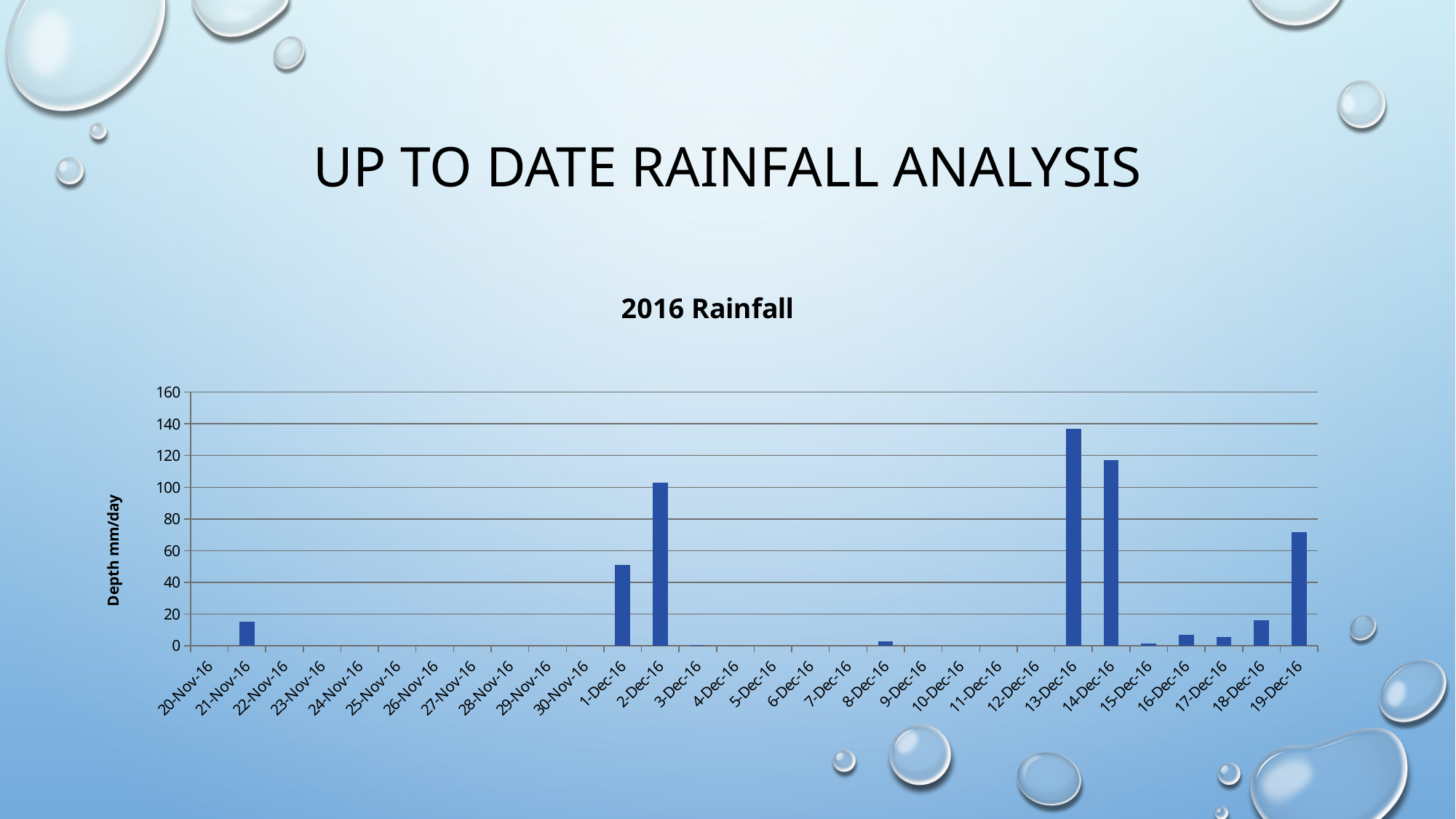
Is the value for 2-Dec-16 greater or less than 100? greater Is the value for 19-Dec-16 greater or less than 80? less Which date has the highest rainfall depth? 13-Dec-16 Which is larger, the value for 2-Dec-16 or the value for 19-Dec-16? 2-Dec-16 Which is larger, the value for 13-Dec-16 or the value for 14-Dec-16? 13-Dec-16 Is the value for 1-Dec-16 greater or less than 60? less How many dates are shown along the x axis? 30 What is the label on the vertical axis of the chart? Depth mm/day What is the title of the chart? 2016 Rainfall What kind of chart is shown on the slide? Bar chart